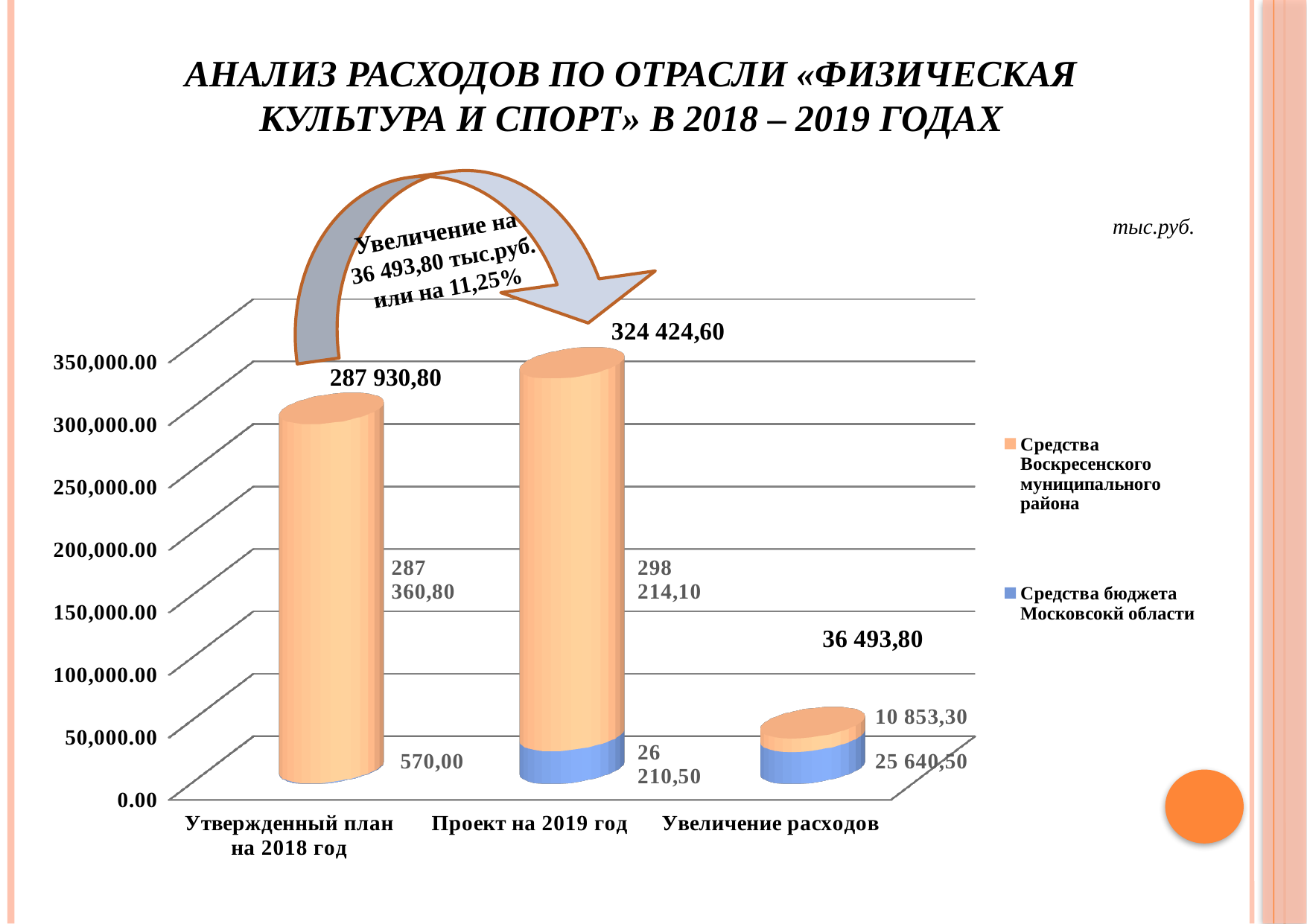
What is the total of the stacked bar for 'Проект на 2019 год'? 324 424,60 What is the value of 'Средства Воскресенского муниципального района' for 'Утвержденный план на 2018 год'? 287 360,80 How many series does the chart legend list? 2 What kind of chart is shown on the slide? Stacked bar chart What is the total of the stacked bar for 'Увеличение расходов'? 36 493,80 Which is larger for 'Увеличение расходов': 'Средства Воскресенского муниципального района' or 'Средства бюджета Московской области'? Средства бюджета Московской области Which category has the lowest total value? Увеличение расходов What is the value of 'Средства бюджета Московской области' for 'Проект на 2019 год'? 26 210,50 What is the value of 'Средства бюджета Московской области' for 'Утвержденный план на 2018 год'? 570,00 How many categories are shown on the x axis of the chart? 3 Which category has the highest total value? Проект на 2019 год What is the value of 'Средства Воскресенского муниципального района' for 'Увеличение расходов'? 10 853,30